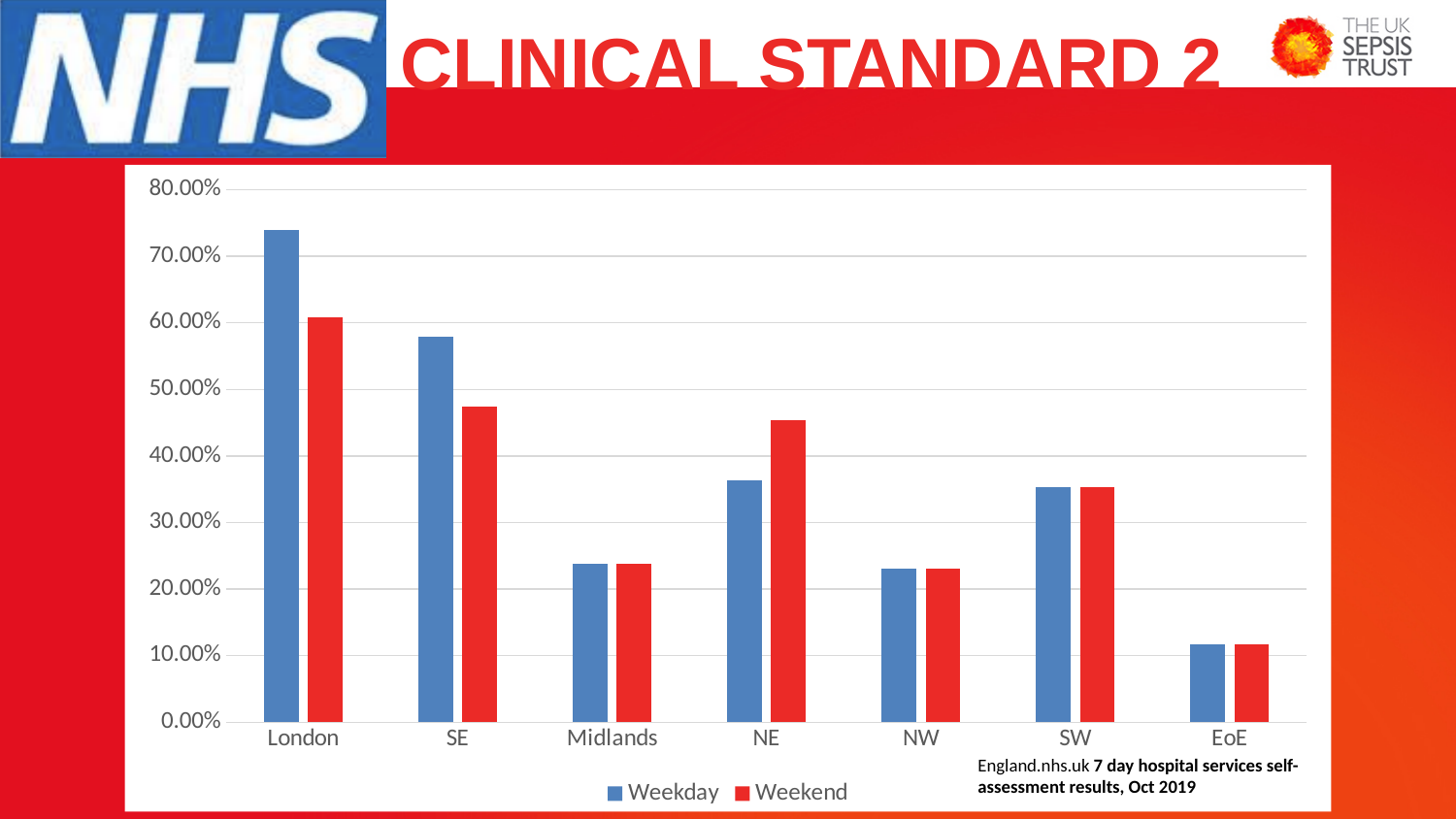
How many series does the legend list? 2 Is the Weekend value for NE greater or less than 40.00%? greater What are the two entries in the chart legend? Weekday and Weekend Which region has the lowest Weekday value? EoE Is the Weekend value for SE greater or less than 50.00%? less What kind of chart is shown on the slide? bar chart How many regions are shown on the x axis? 7 For London, which is larger: the Weekday value or the Weekend value? Weekday Which region has the lowest Weekend value? EoE Is the Weekday value for London greater or less than 70.00%? greater Which region has the highest Weekday value? London For NE, which is larger: the Weekday value or the Weekend value? Weekend